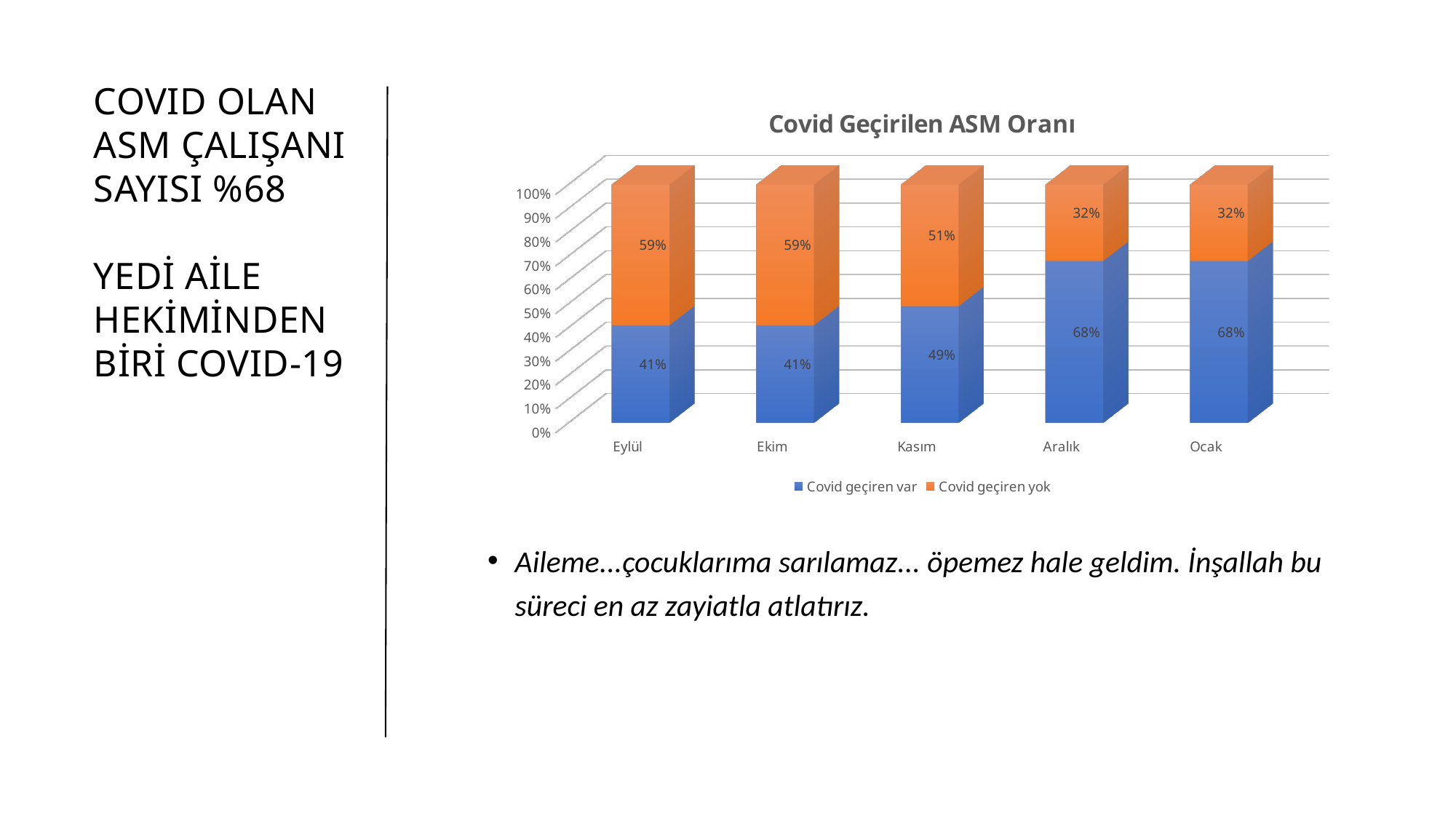
How many months are shown on the x axis? 5 Which month has the lowest value for "Covid geçiren yok"? Aralık and Ocak (32%) How many series does the legend list? 2 What kind of chart is shown? Stacked bar chart What is the value of "Covid geçiren var" for Kasım? 49% What is the value of "Covid geçiren yok" for Ocak? 32% What is the value of "Covid geçiren var" for Aralık? 68% Does the "Covid geçiren var" value rise or fall from Eylül to Ocak? Rise What is the difference between the "Covid geçiren var" values for Aralık and Eylül? 27% Which is larger for Kasım: "Covid geçiren var" or "Covid geçiren yok"? Covid geçiren yok What is the value of "Covid geçiren yok" for Eylül? 59% What is the title of the chart? Covid Geçirilen ASM Oranı